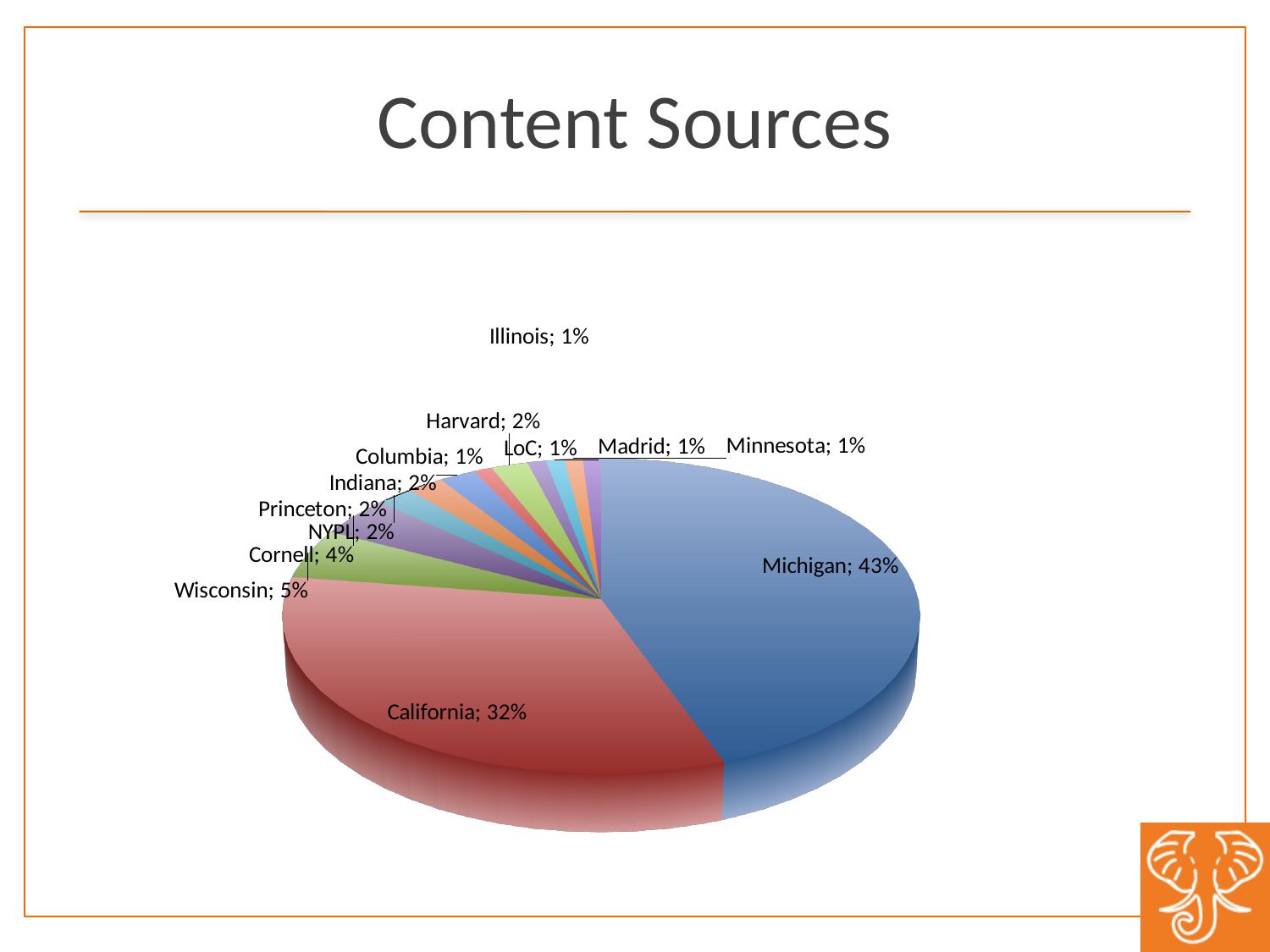
What is the value for Cornell? 4% What share of the pie does California have? 32% What is the value for Wisconsin? 5% Which is larger, the share for Wisconsin or the share for Cornell? Wisconsin Which content source has the largest slice? Michigan What is the title of the chart? Content Sources What is the value for Harvard? 2% How many content sources are shown in the pie chart? 13 What kind of chart is shown on the slide? Pie chart What is the difference between the Michigan and California shares? 11% What share of the pie does Michigan have? 43% What is the combined share of Michigan and California? 75%